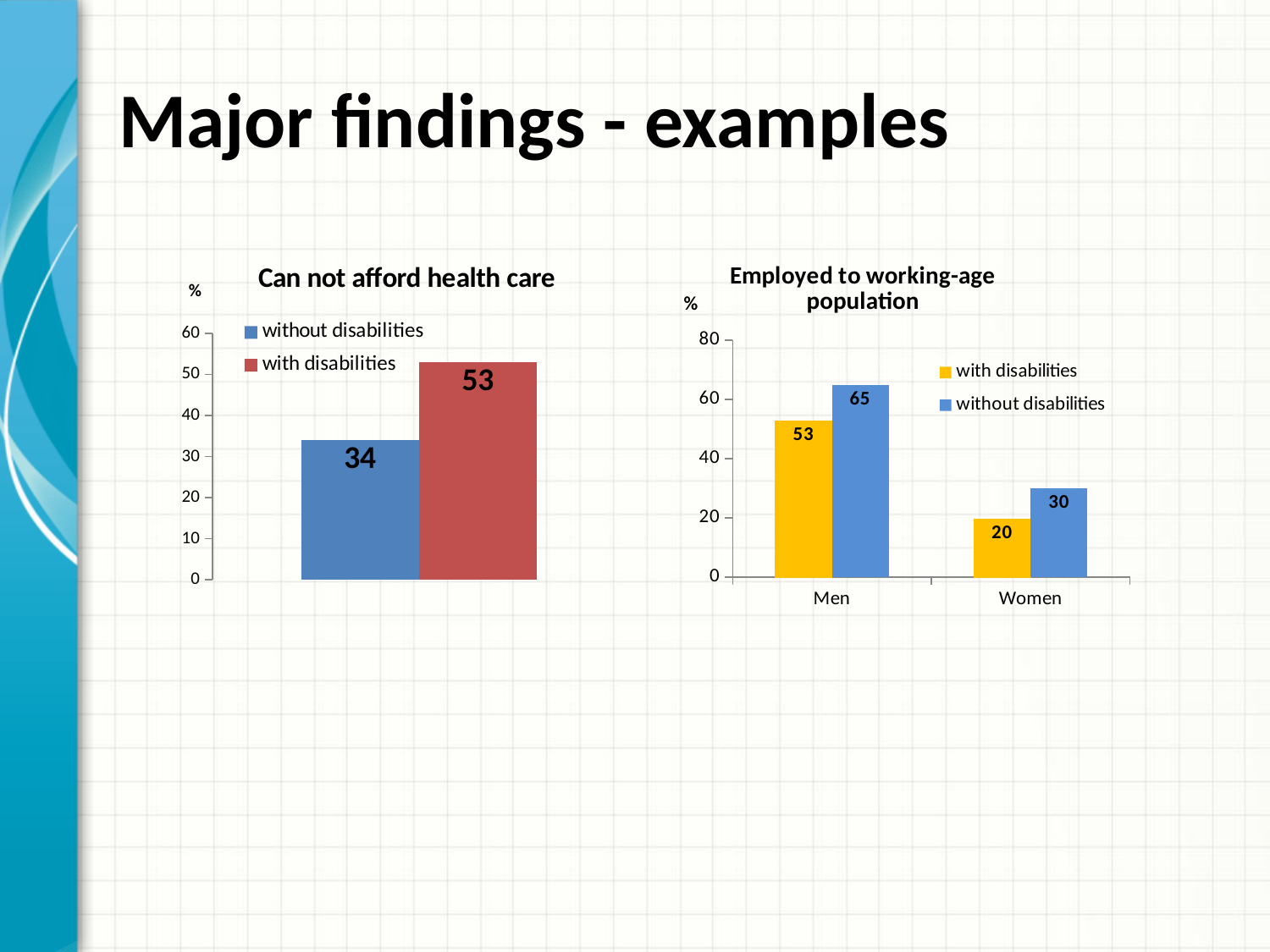
In the 'Employed to working-age population' chart, what is the difference between men without disabilities and men with disabilities? 12 In the 'Employed to working-age population' chart, how many categories are shown on the x axis? 2 In the 'Employed to working-age population' chart, which bar has the lowest value? Women with disabilities In the 'Can not afford health care' chart, what is the difference between the values for people with disabilities and without disabilities? 19 In the 'Employed to working-age population' chart, is the value for women with disabilities larger or smaller than the value for men with disabilities? smaller In the 'Can not afford health care' chart, what is the value for people with disabilities? 53 In the 'Employed to working-age population' chart, what is the value for men with disabilities? 53 In the 'Can not afford health care' chart, which group has the higher value? with disabilities In the 'Can not afford health care' chart, how many series does the legend list? 2 What type of chart is the 'Employed to working-age population' chart? bar chart In the 'Can not afford health care' chart, what is the value for people without disabilities? 34 In the 'Employed to working-age population' chart, what is the value for women without disabilities? 30